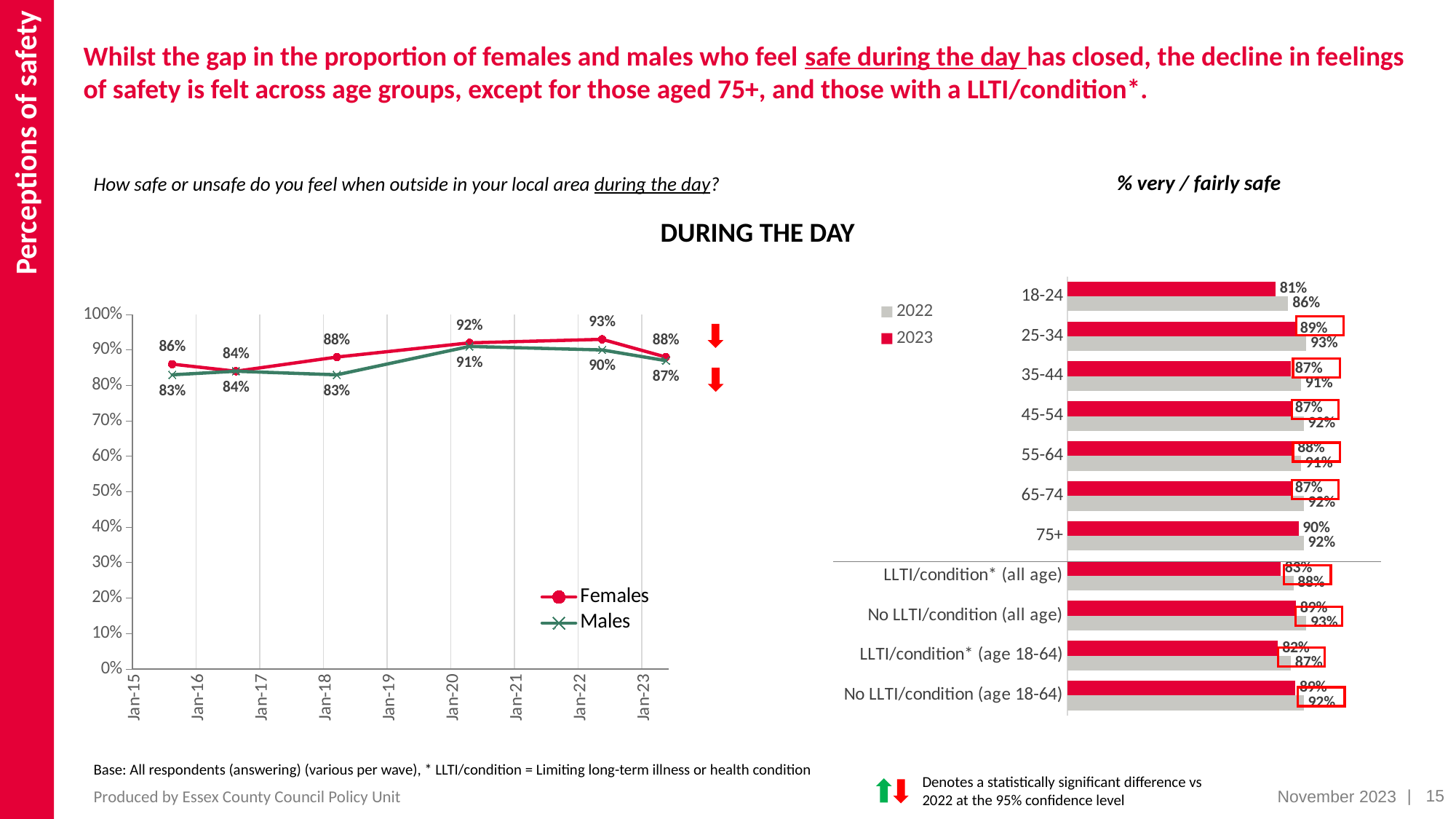
In the line chart on the left, what is the final (most recent) value for Females? 88% In the line chart on the left, what is the highest value shown for Females? 93% In the line chart on the left, what is the final (most recent) value for Males? 87% In the bar chart on the right, which age group has the highest 2023 value? 75+ What kind of chart is the chart on the right of the slide? bar chart In the line chart on the left, how many series does the legend list? 2 What kind of chart is the chart on the left of the slide? line chart In the line chart on the left, what is the difference between the first Females value (86%) and the first Males value (83%)? 3 percentage points In the bar chart on the right, what is the 2022 value for 25-34? 93% In the bar chart on the right, what is the 2023 value for 18-24? 81% In the bar chart on the right, what is the difference between the 2022 and 2023 values for 45-54? 5 percentage points In the line chart on the left, what is the lowest value shown for Males? 83%